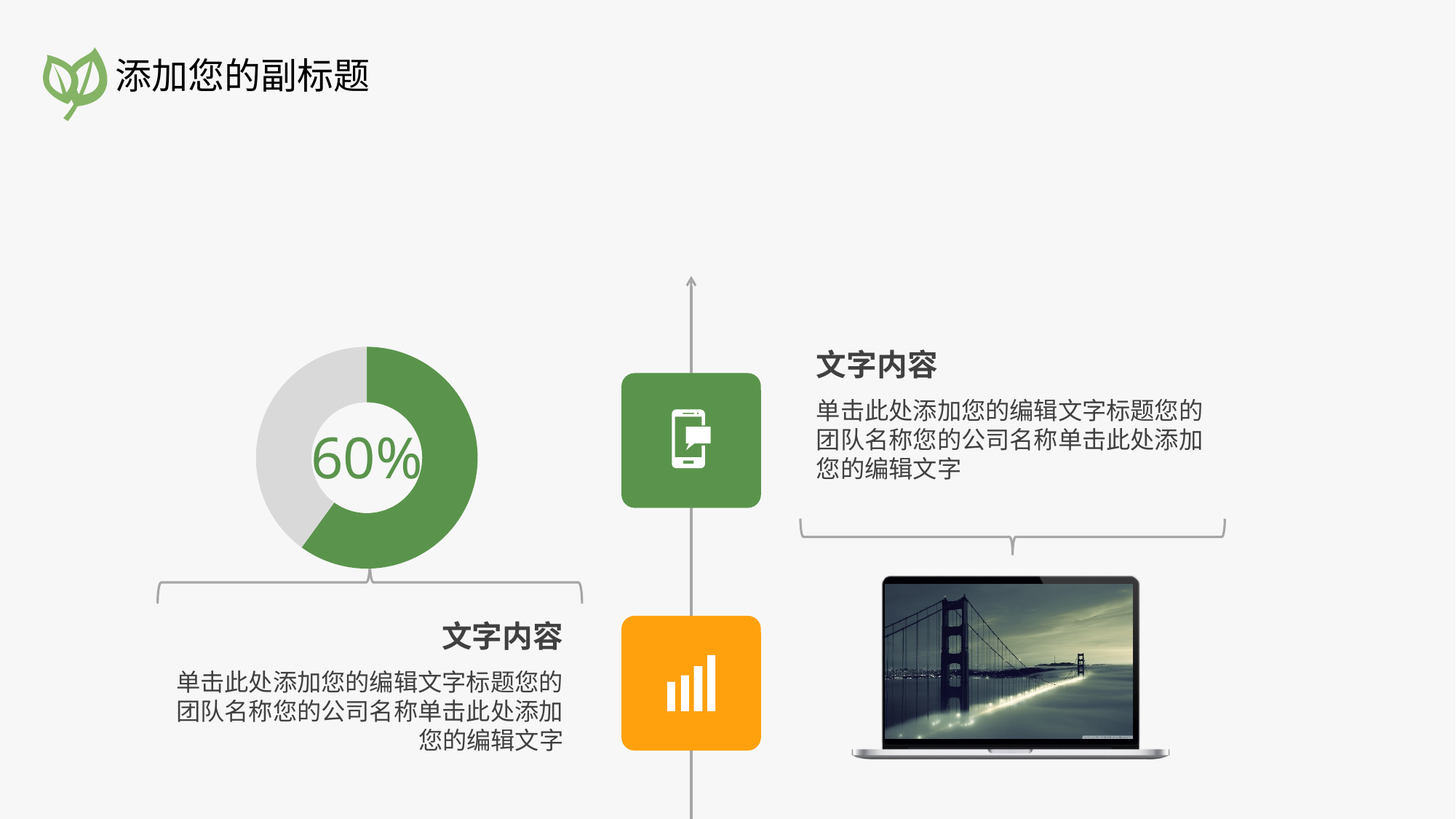
What share of the doughnut chart does the green segment represent? 60% Which segment of the doughnut chart is larger, the green one or the grey one? green What colour is the larger segment of the doughnut chart? green Is the green segment of the doughnut chart greater or less than 50% of the whole? greater What percentage is printed in the centre of the doughnut chart? 60% What kind of chart is shown on the left of the slide? doughnut chart How many segments does the doughnut chart have? 2 What colour is the smaller segment of the doughnut chart? grey